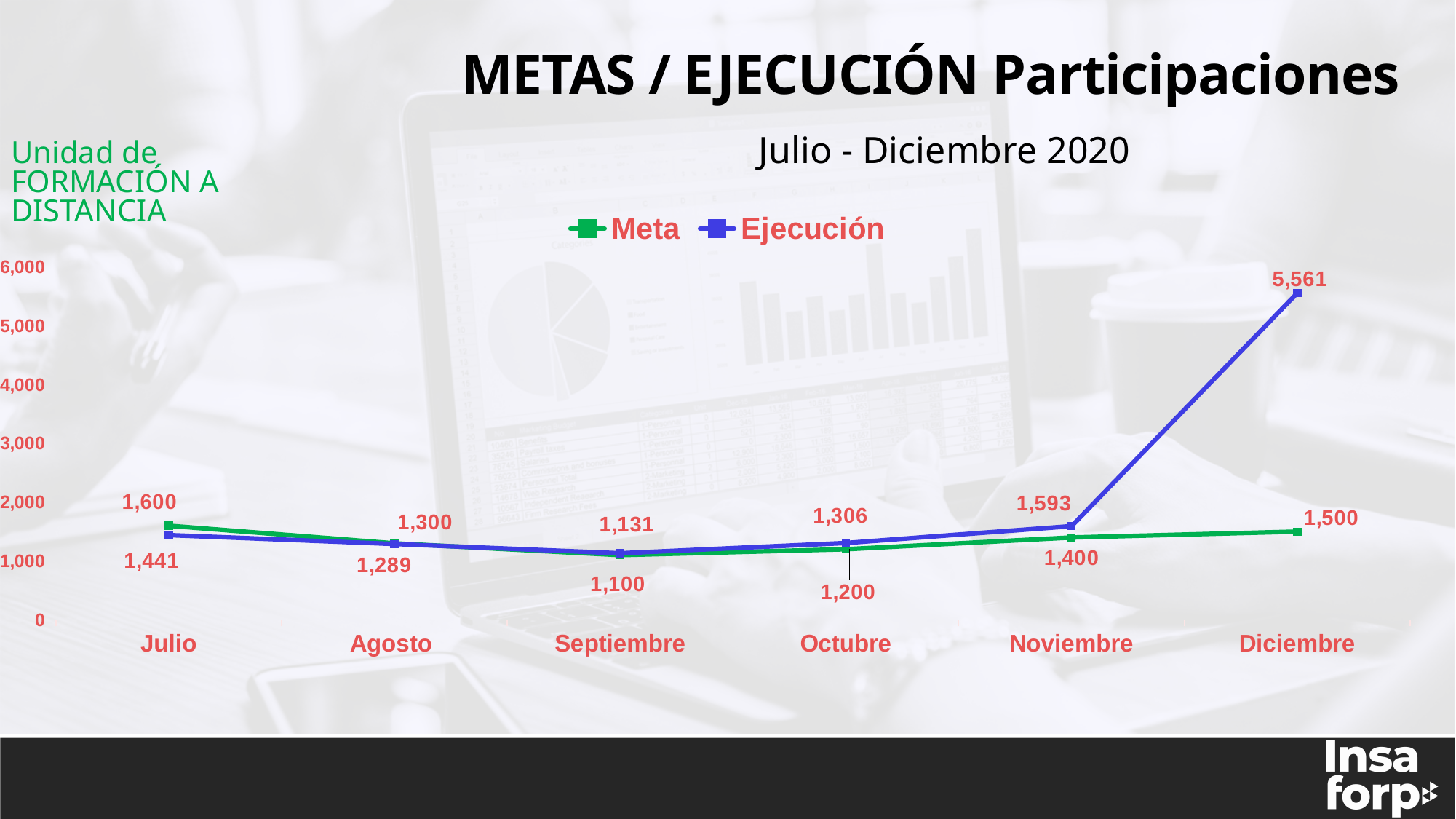
What is the difference between Ejecución and Meta in Diciembre? 4,061 In which month is the Ejecución value highest? Diciembre Which is larger in Julio, Meta or Ejecución? Meta In which month is the Meta value lowest? Septiembre Which series is drawn in green? Meta What type of chart is shown on the slide? line chart What is the Ejecución value for Noviembre? 1,593 How many months are plotted on the x axis? 6 What is the Ejecución value for Diciembre? 5,561 What is the Meta value for Julio? 1,600 How many series does the legend list? 2 What is the Meta value for Septiembre? 1,100